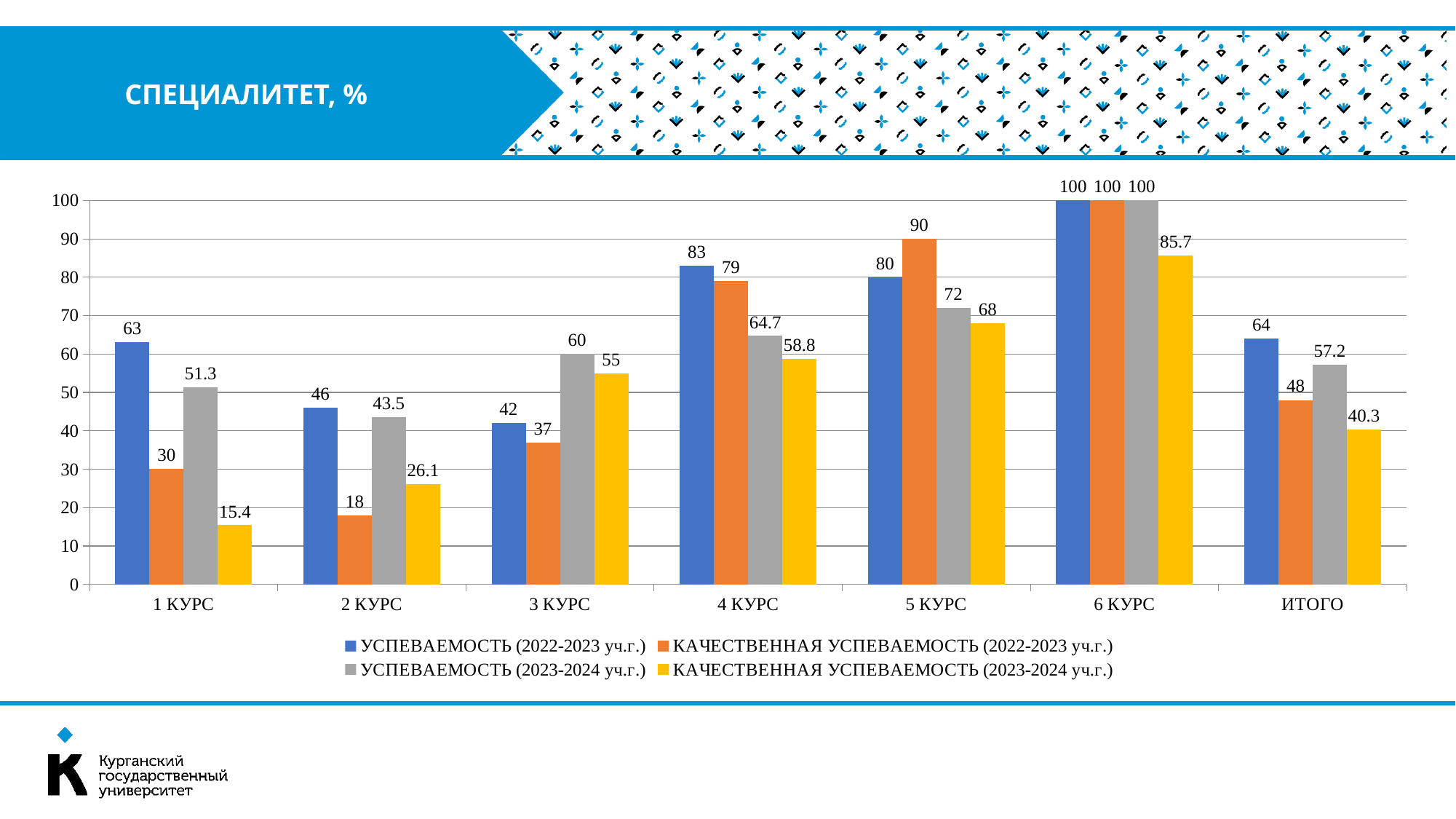
What is the value of УСПЕВАЕМОСТЬ (2023-2024 уч.г.) for ИТОГО? 57.2 What is the difference between УСПЕВАЕМОСТЬ (2022-2023 уч.г.) and УСПЕВАЕМОСТЬ (2023-2024 уч.г.) for 3 КУРС? 18 What is the difference between КАЧЕСТВЕННАЯ УСПЕВАЕМОСТЬ (2022-2023 уч.г.) and КАЧЕСТВЕННАЯ УСПЕВАЕМОСТЬ (2023-2024 уч.г.) for 5 КУРС? 22 Which category has the highest value for КАЧЕСТВЕННАЯ УСПЕВАЕМОСТЬ (2023-2024 уч.г.)? 6 КУРС For 2 КУРС, which is larger: УСПЕВАЕМОСТЬ (2022-2023 уч.г.) or УСПЕВАЕМОСТЬ (2023-2024 уч.г.)? УСПЕВАЕМОСТЬ (2022-2023 уч.г.) What is the value of КАЧЕСТВЕННАЯ УСПЕВАЕМОСТЬ (2023-2024 уч.г.) for 4 КУРС? 58.8 What is the title of the slide? СПЕЦИАЛИТЕТ, % Which category has the lowest value for КАЧЕСТВЕННАЯ УСПЕВАЕМОСТЬ (2022-2023 уч.г.)? 2 КУРС How many categories are shown on the x axis? 7 How many series does the legend list? 4 What is the value of УСПЕВАЕМОСТЬ (2022-2023 уч.г.) for 1 КУРС? 63 What kind of chart is shown on the slide? Bar chart